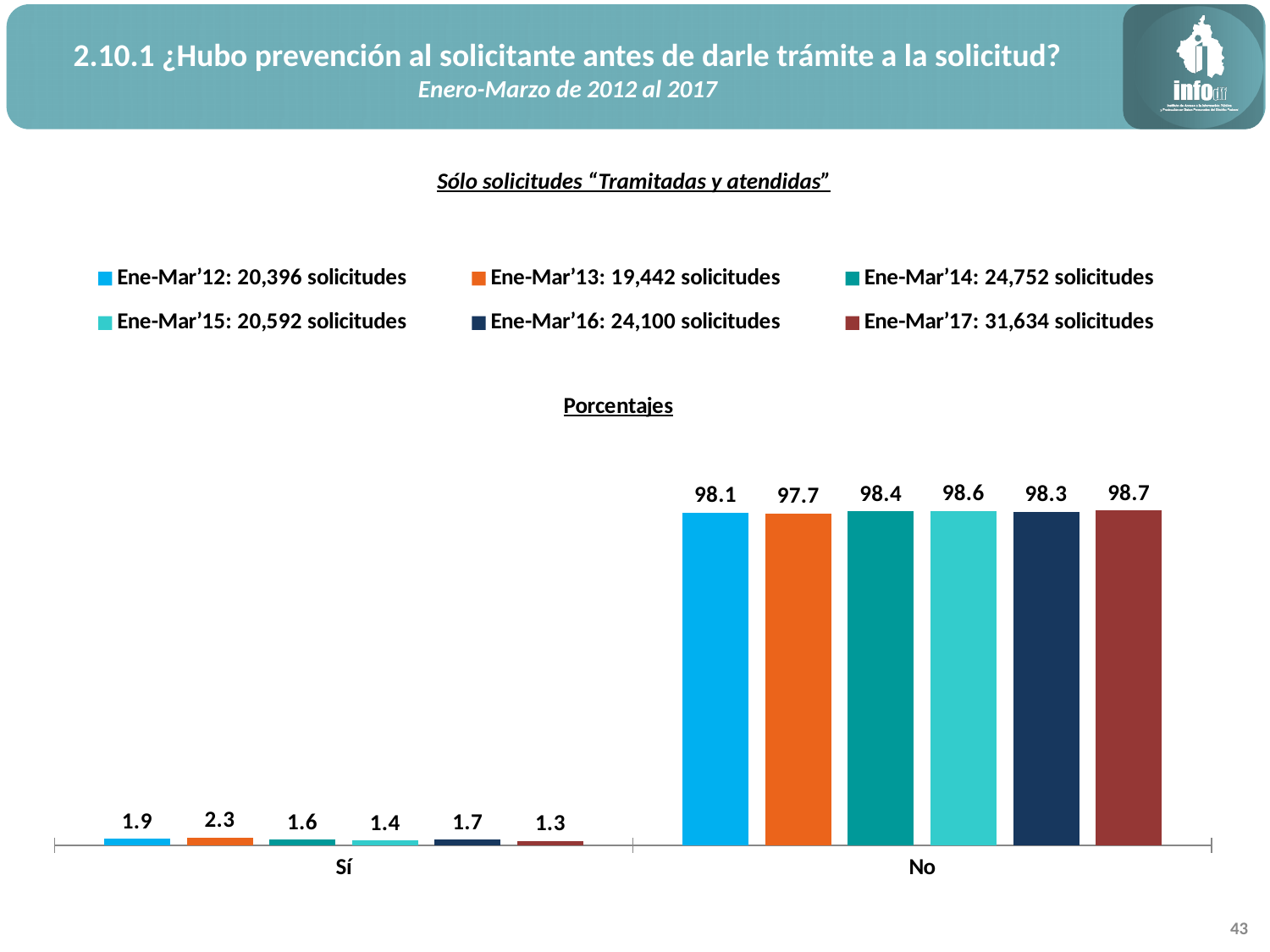
What is the difference between the "Sí" values for Ene-Mar'13 and Ene-Mar'17? 1.0 What is the value for Ene-Mar'13 in the "Sí" category? 2.3 What is the value for Ene-Mar'17 in the "No" category? 98.7 How many series does the legend list? 6 What is the value for Ene-Mar'15 in the "Sí" category? 1.4 Which series has the highest value in the "Sí" category? Ene-Mar'13 What is the difference between the "No" values for Ene-Mar'17 and Ene-Mar'12? 0.6 What kind of chart is shown on the slide? Bar chart Which series has the lowest value in the "No" category? Ene-Mar'13 Which is larger: the "Sí" value for Ene-Mar'12 or for Ene-Mar'16? Ene-Mar'12 According to the legend, how many solicitudes were there in Ene-Mar'17? 31,634 solicitudes How many categories are shown on the x axis? 2